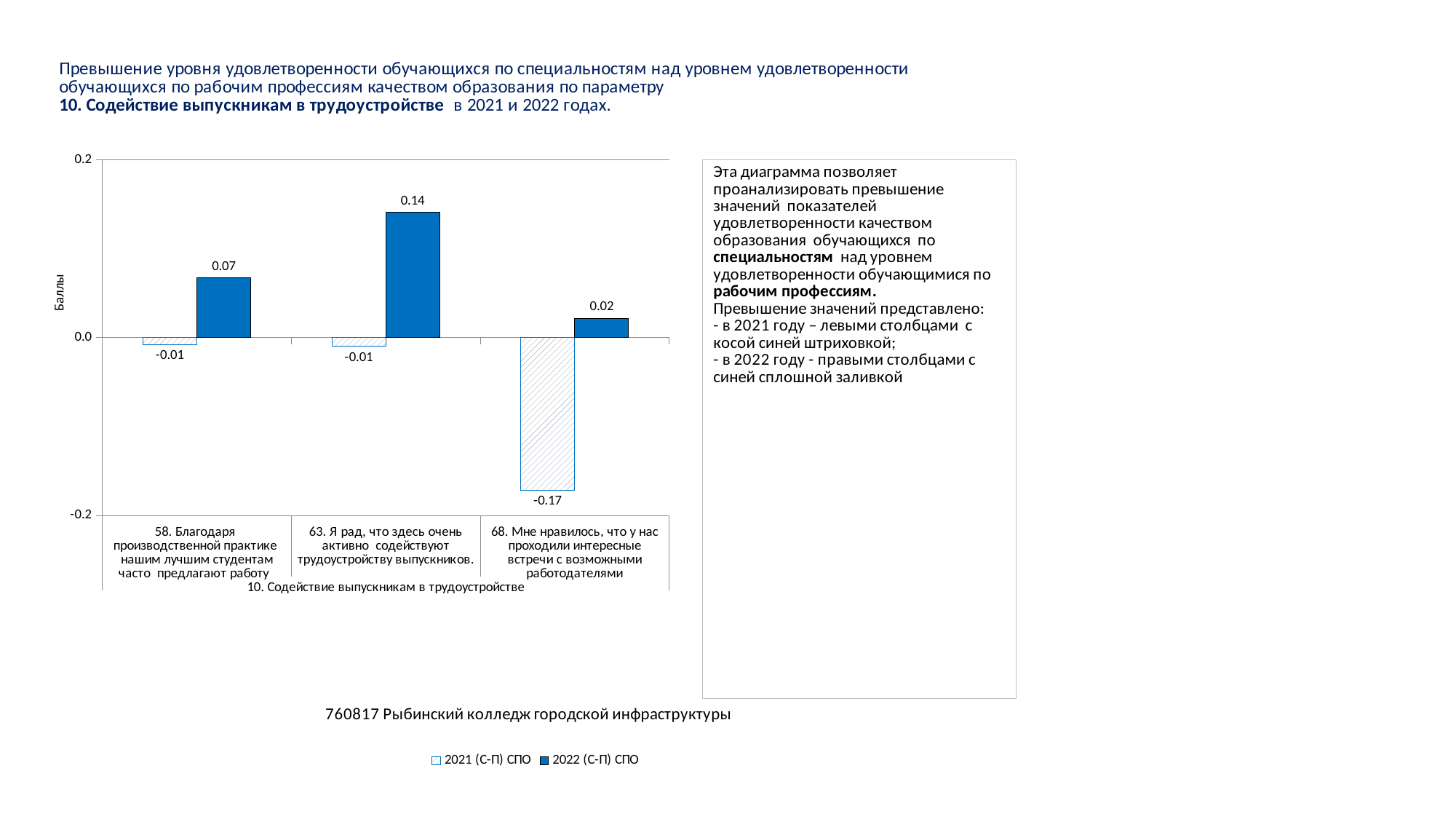
What is the label of the vertical axis of the chart? Баллы What is the difference between the 2022 (С-П) СПО and 2021 (С-П) СПО values for category "63. Я рад, что здесь очень активно содействуют трудоустройству выпускников."? 0.15 How many series does the chart legend list? 2 What is the value for 2021 (С-П) СПО for category "58. Благодаря производственной практике нашим лучшим студентам часто предлагают работу"? -0.01 What is the value for 2022 (С-П) СПО for category "58. Благодаря производственной практике нашим лучшим студентам часто предлагают работу"? 0.07 What kind of chart is shown on the slide? Bar chart Which is larger for category "68. Мне нравилось, что у нас проходили интересные встречи с возможными работодателями": the 2021 (С-П) СПО value or the 2022 (С-П) СПО value? 2022 (С-П) СПО How many categories are shown on the x axis of the chart? 3 Which category has the lowest value for the 2021 (С-П) СПО series? 68. Мне нравилось, что у нас проходили интересные встречи с возможными работодателями What is the value for 2021 (С-П) СПО for category "68. Мне нравилось, что у нас проходили интересные встречи с возможными работодателями"? -0.17 Which category has the highest value for the 2022 (С-П) СПО series? 63. Я рад, что здесь очень активно содействуют трудоустройству выпускников. What is the value for 2022 (С-П) СПО for category "63. Я рад, что здесь очень активно содействуют трудоустройству выпускников."? 0.14